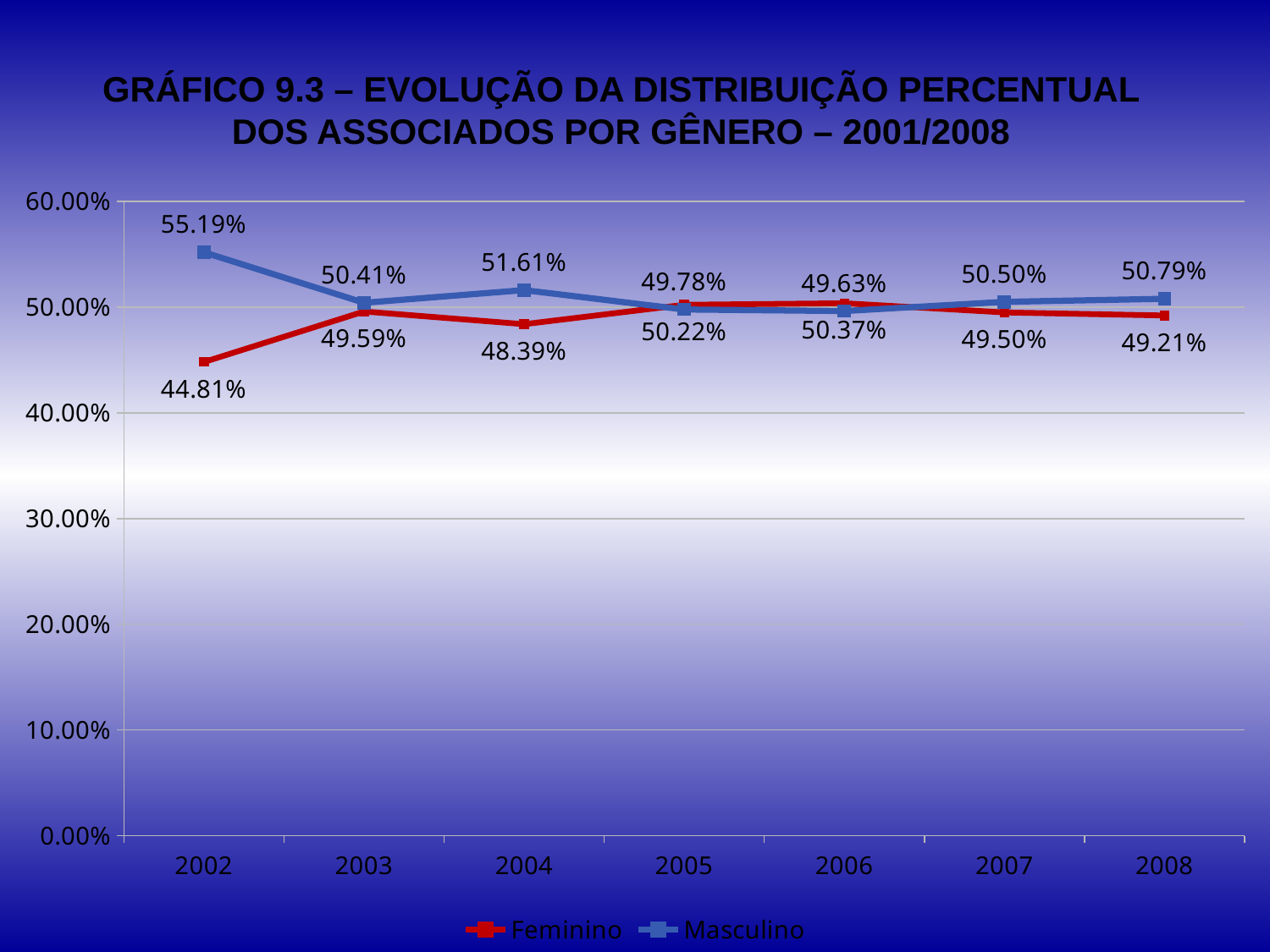
What is the value for Feminino in 2008? 49.21% What is the value for Masculino in 2004? 51.61% What type of chart is shown on the slide? line chart What is the difference between the Masculino and Feminino values in 2002? 10.38 percentage points Does the Feminino value rise or fall from 2002 to 2003? rise How many years are plotted along the x axis? 7 What is the value for Feminino in 2002? 44.81% What is the value for Masculino in 2002? 55.19% In which year is the Feminino value lowest? 2002 How many series does the legend list? 2 In which year is the Masculino value highest? 2002 Which series has the larger value in 2002, Feminino or Masculino? Masculino